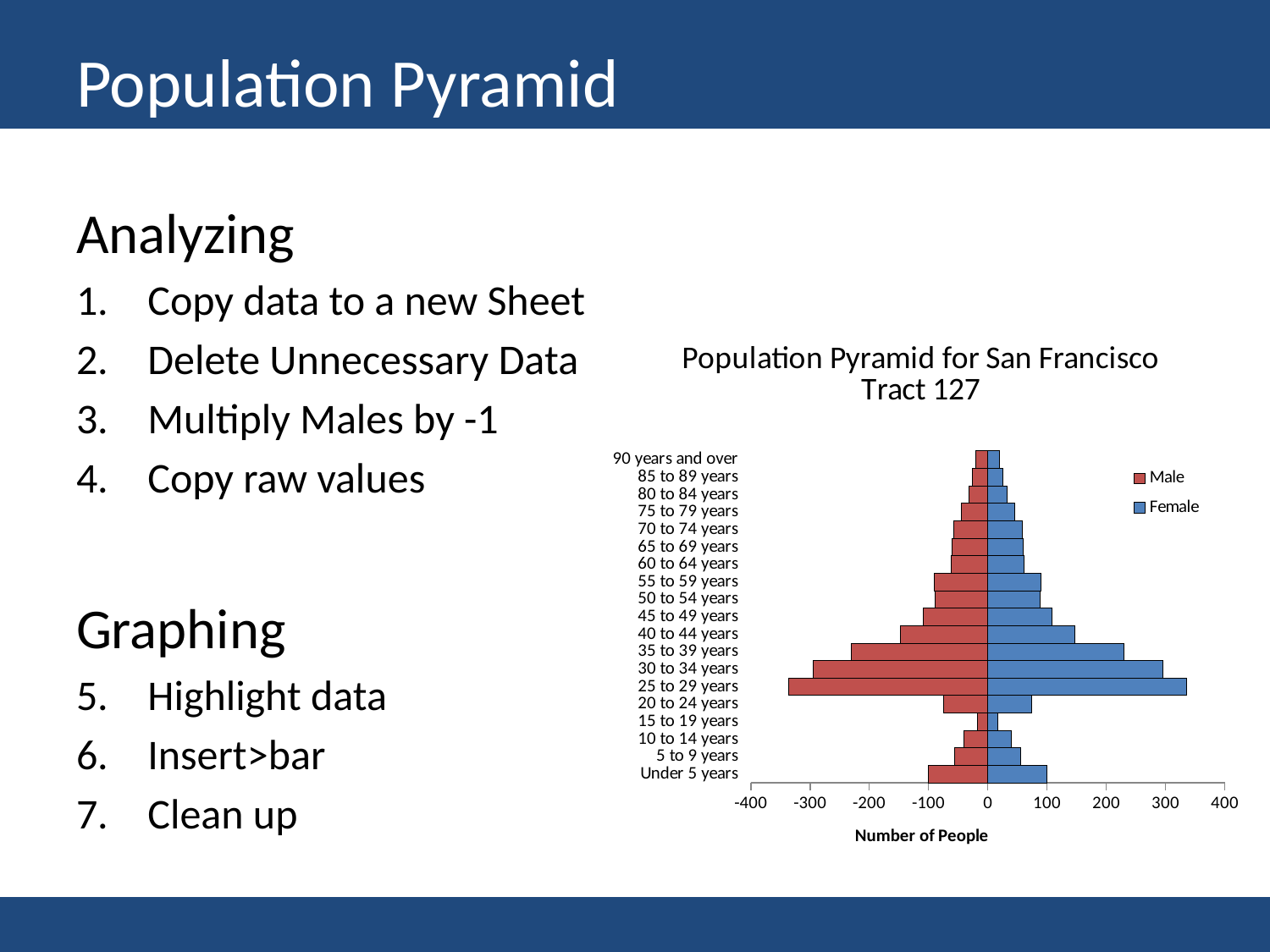
What type of chart is shown on the slide? bar chart What is the title of the chart? Population Pyramid for San Francisco Tract 127 Moving from 25 to 29 years up to 90 years and over, do the Female bars generally get longer or shorter? shorter Is the Female value for 25 to 29 years greater or less than 300? greater Is the Female value for 20 to 24 years greater or less than 100? less How many age group categories are plotted on the chart? 19 Is the Female value for 35 to 39 years greater or less than 200? greater Which has the longer Female bar, 40 to 44 years or 45 to 49 years? 40 to 44 years Which age group has the longest Male bar? 25 to 29 years How many series does the chart legend list? 2 What is the label of the horizontal axis? Number of People Which age group has the longest Female bar? 25 to 29 years